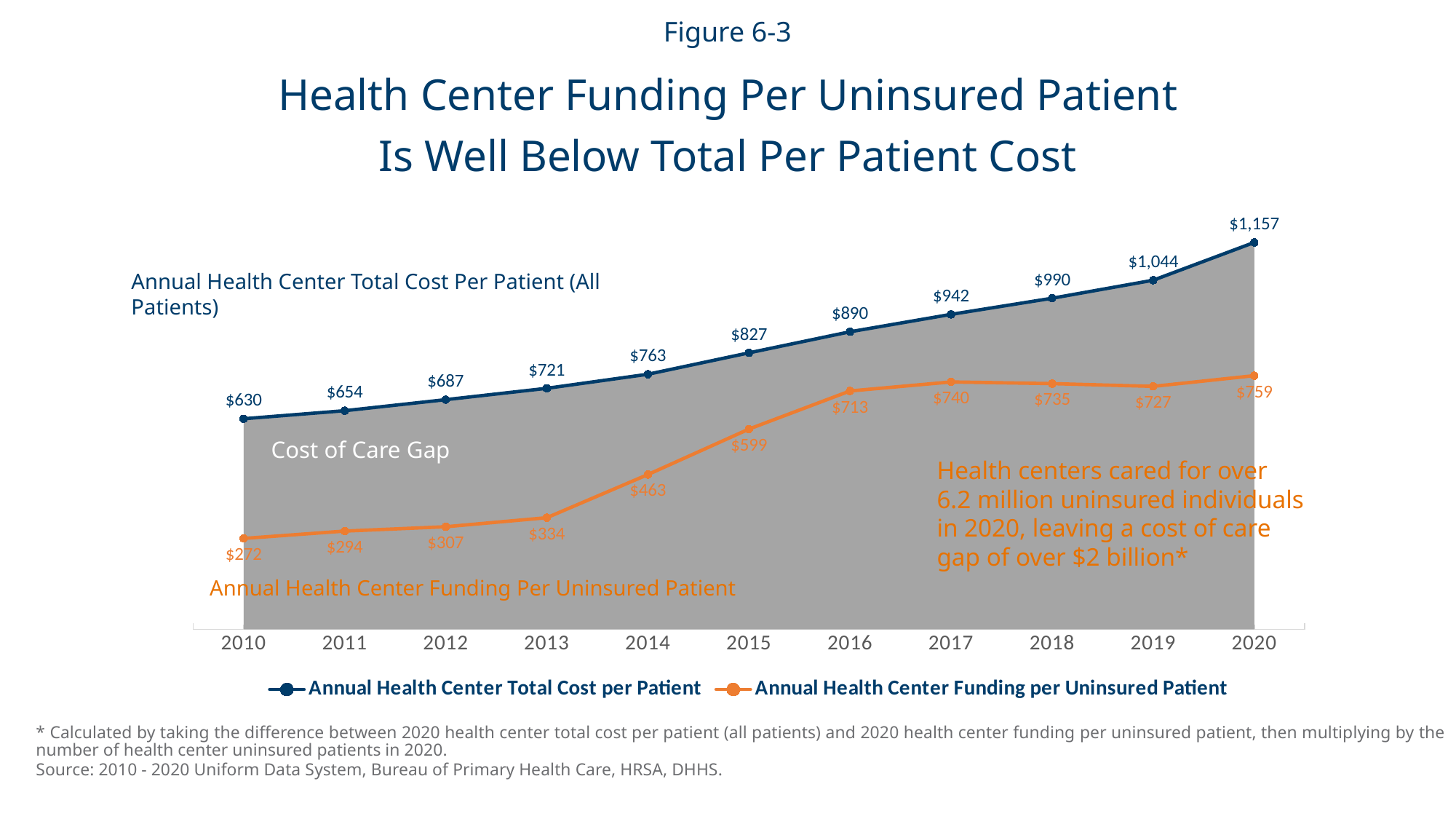
What was the Annual Health Center Total Cost per Patient in 2015? $827 How many years are shown on the x axis? 11 What is the difference between the Annual Health Center Total Cost per Patient and the Annual Health Center Funding per Uninsured Patient in 2020? $398 What was the Annual Health Center Funding per Uninsured Patient in 2014? $463 What label is written in the shaded grey area between the two lines? Cost of Care Gap Does the Annual Health Center Total Cost per Patient rise or fall from 2010 to 2020? Rise How many series does the legend list? 2 What was the Annual Health Center Total Cost per Patient in 2020? $1,157 Which is larger: the Annual Health Center Funding per Uninsured Patient in 2017 or in 2019? 2017 What kind of chart is shown on the slide? Line chart In which year was the Annual Health Center Funding per Uninsured Patient highest? 2020 In which year was the Annual Health Center Total Cost per Patient lowest? 2010